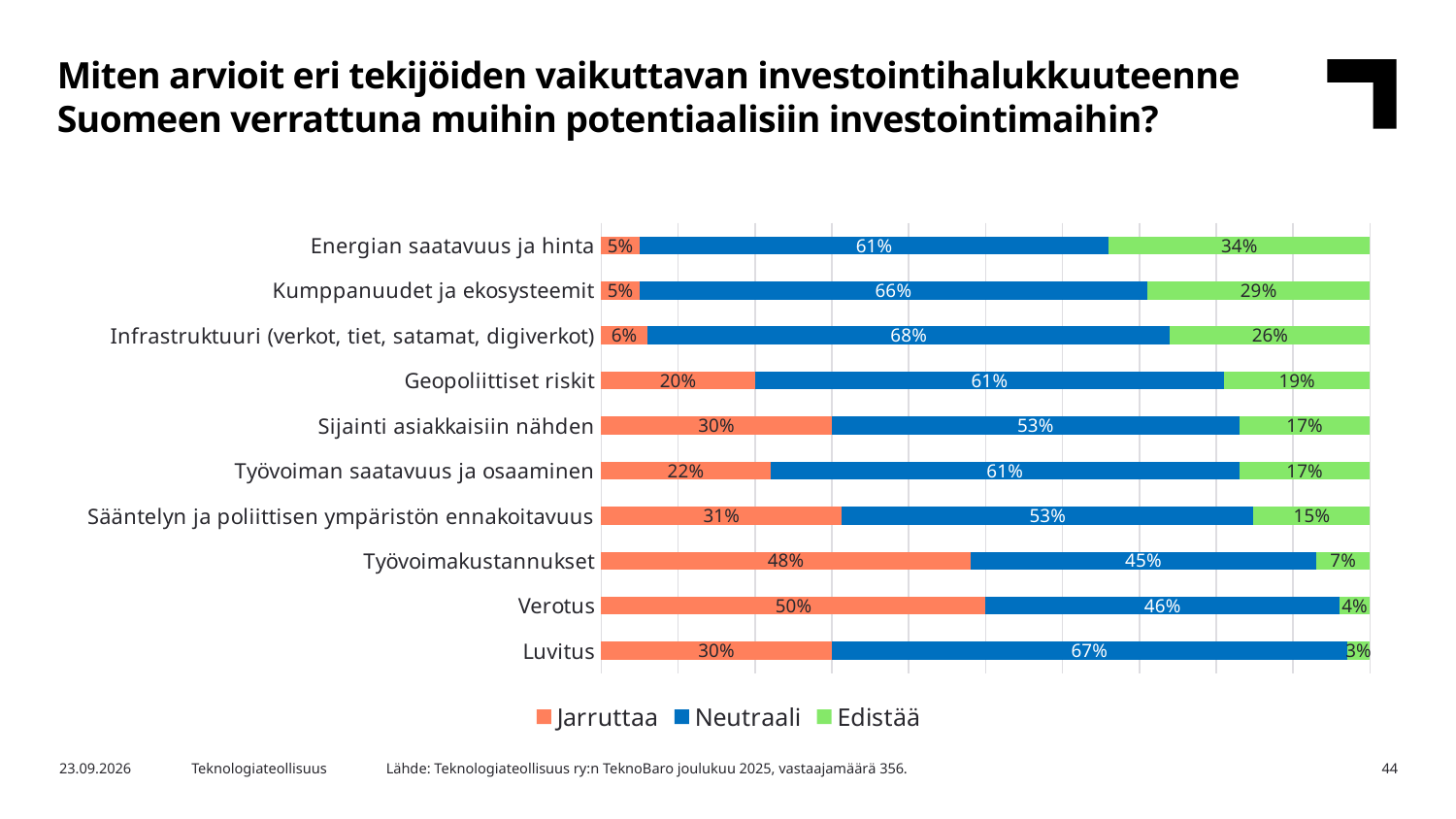
How many categories are shown in the chart? 10 Which category has the highest Jarruttaa value? Verotus What is the Neutraali value for Luvitus? 67% Which category has the lowest Edistää value? Luvitus What is the Jarruttaa value for Verotus? 50% How many series does the legend list? 3 What kind of chart is shown on the slide? Stacked bar chart What is the difference between the Neutraali values for Infrastruktuuri (verkot, tiet, satamat, digiverkot) and Sijainti asiakkaisiin nähden? 15% What is the total of the three segments for Kumppanuudet ja ekosysteemit? 100% Which is larger: the Jarruttaa value for Työvoimakustannukset or the Jarruttaa value for Geopoliittiset riskit? Työvoimakustannukset What is the Edistää value for Energian saatavuus ja hinta? 34% Which legend entry is shown in green? Edistää